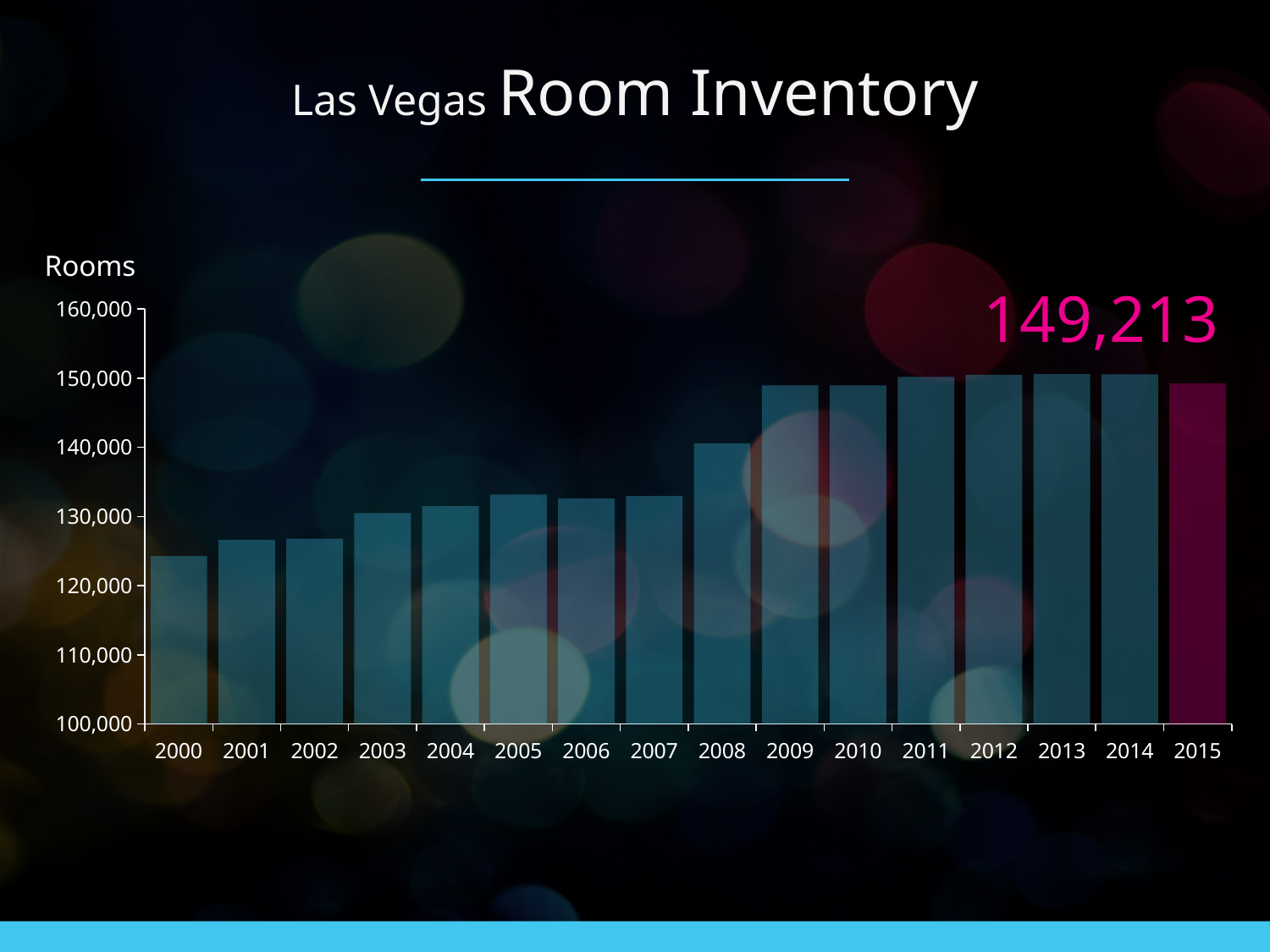
How many years are shown on the x axis? 16 Is the value for 2011 greater or less than 140,000? greater Is the value for 2008 greater or less than 150,000? less Is the value for 2005 greater or less than 130,000? greater What kind of chart is shown on the slide? Bar chart Which year has the lowest room inventory? 2000 What is the value shown for 2015? 149,213 Do the values generally rise or fall from 2000 to 2014? rise Which year has the larger value, 2000 or 2015? 2015 What is the label on the vertical axis of the chart? Rooms Which year has the larger value, 2008 or 2009? 2009